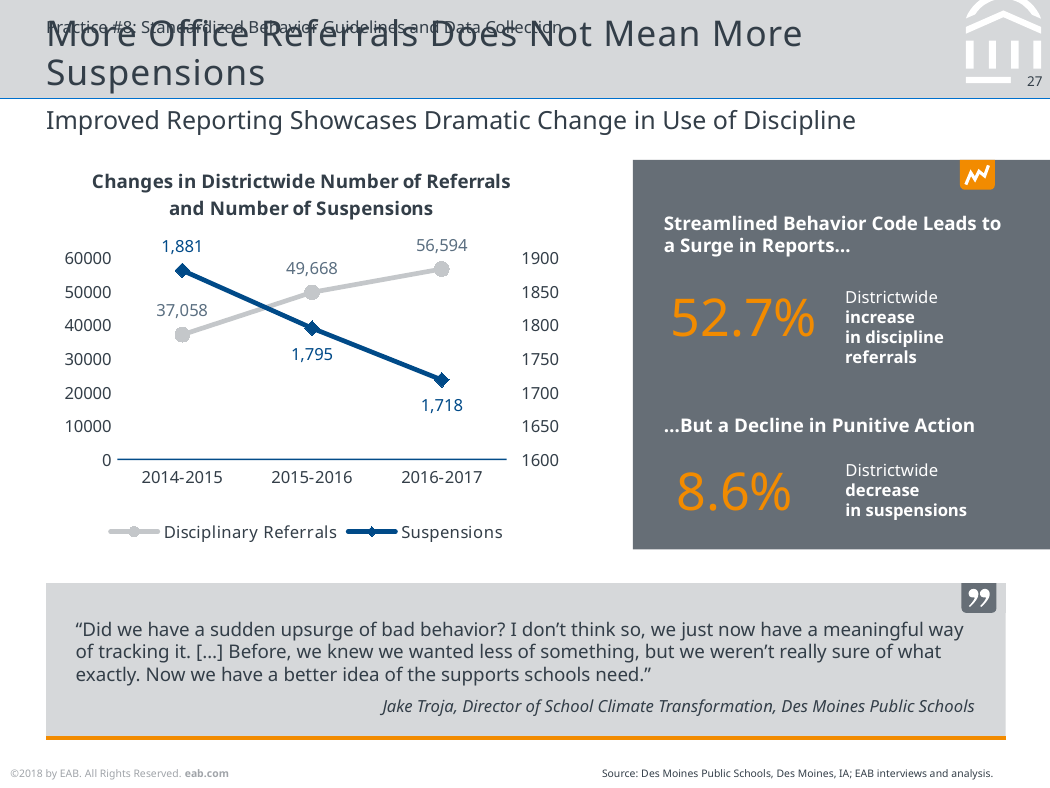
Do Suspensions rise or fall from 2014-2015 to 2016-2017? fall Which year had more Suspensions, 2014-2015 or 2015-2016? 2014-2015 What is the value for Disciplinary Referrals in 2014-2015? 37,058 What is the value for Suspensions in 2016-2017? 1,718 What is the difference in Disciplinary Referrals between 2016-2017 and 2014-2015? 19,536 In which school year were Disciplinary Referrals highest? 2016-2017 How many school years are shown on the x axis? 3 What is the difference in Suspensions between 2014-2015 and 2016-2017? 163 What is the value for Suspensions in 2014-2015? 1,881 What is the value for Disciplinary Referrals in 2015-2016? 49,668 How many series does the legend list? 2 In which school year were Suspensions lowest? 2016-2017